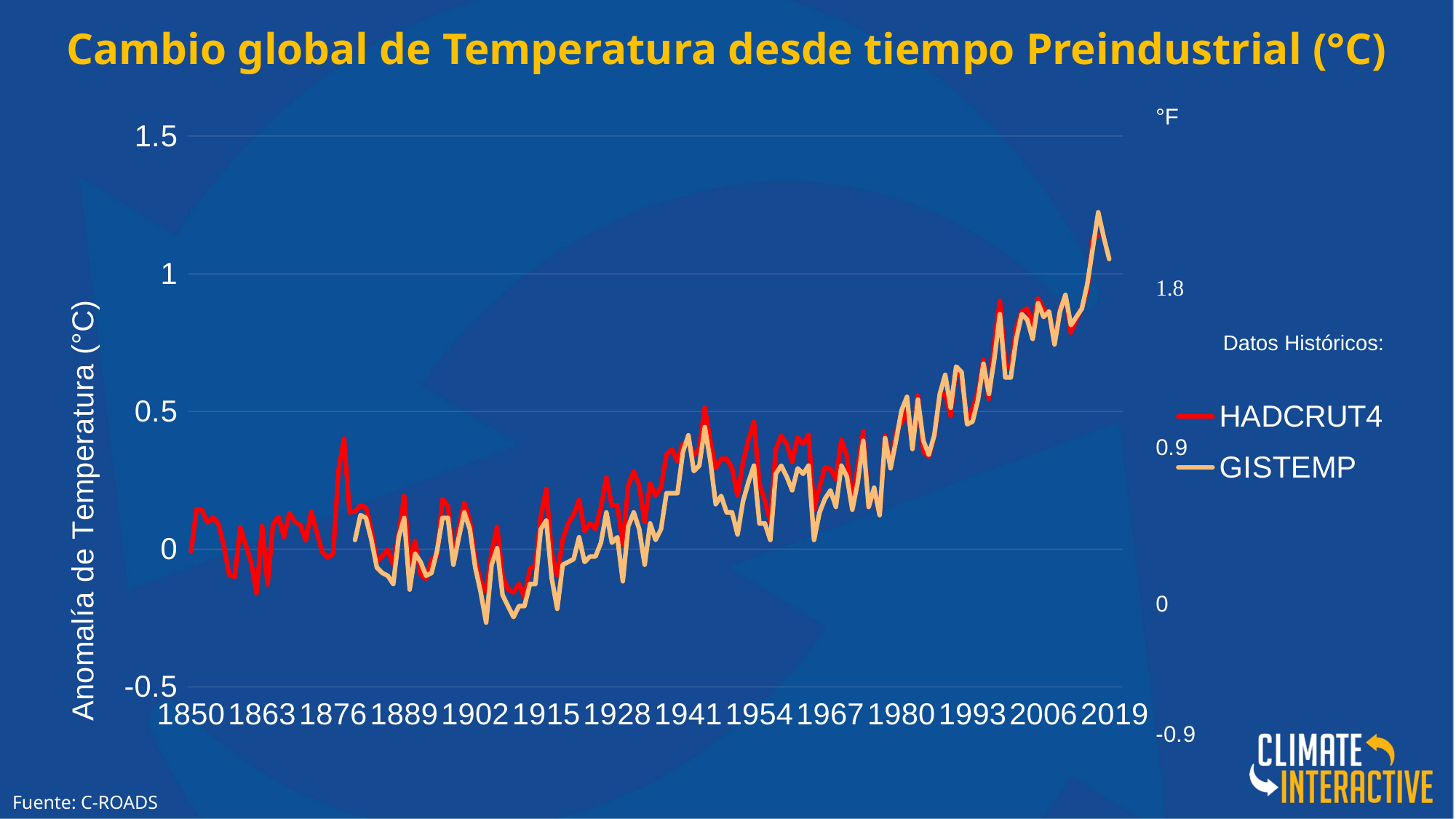
What is the title of the chart? Cambio global de Temperatura desde tiempo Preindustrial (°C) How many series does the legend list? 2 Is the highest GISTEMP value (around 2016) greater or less than 1? greater Is the HADCRUT4 value around 1941 greater or less than 0? greater Is the HADCRUT4 value around 1850 greater or less than 0.5? less What kind of chart is shown on the slide? line chart Which two series are listed in the legend under 'Datos Históricos'? HADCRUT4 and GISTEMP Overall, do the temperature anomaly values rise or fall from 1850 to 2019? rise